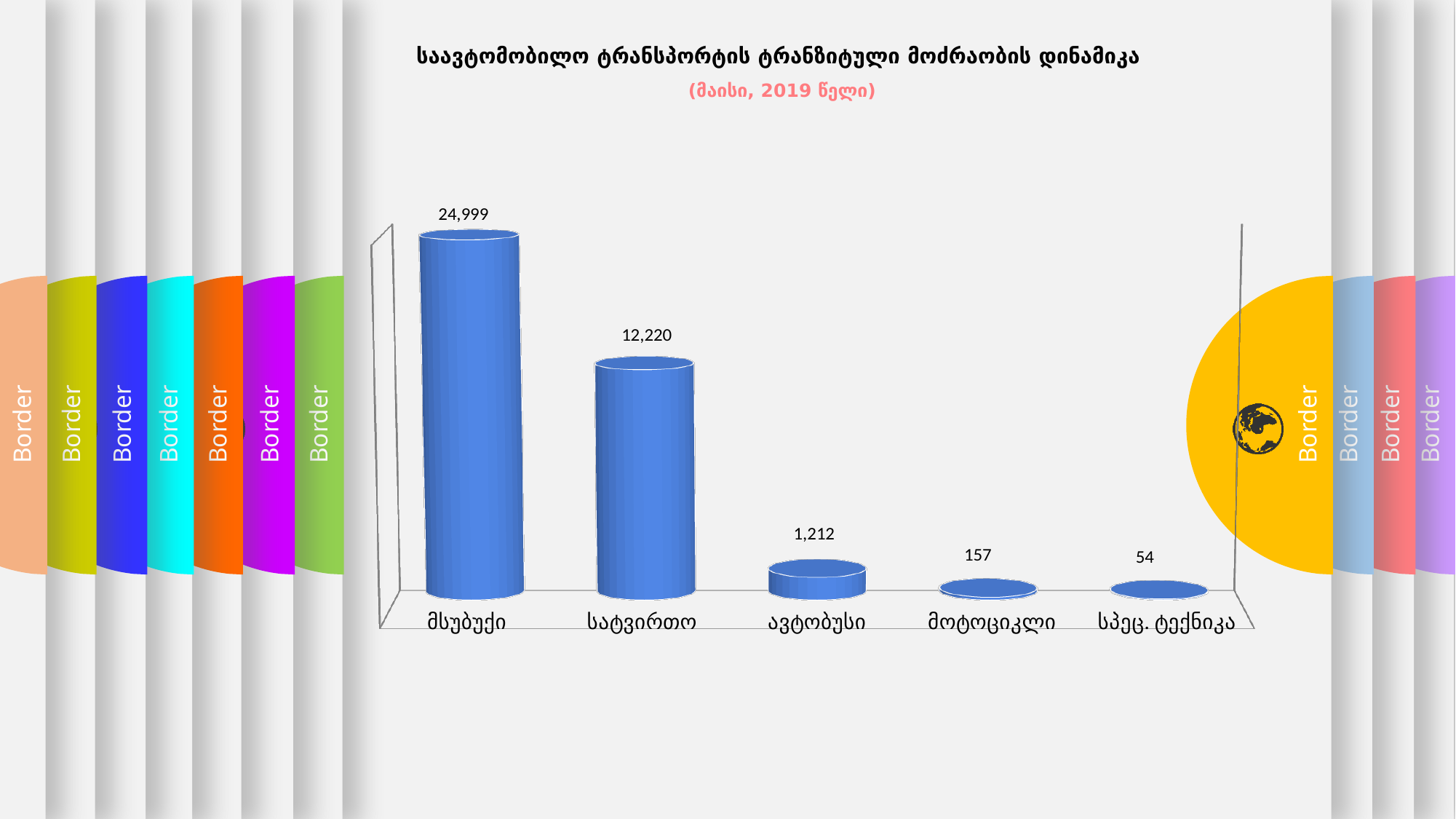
What is the value for სპეც. ტექნიკა? 54 Which is larger, the value for ავტობუსი or the value for მოტოციკლი? ავტობუსი Which month and year does the chart subtitle refer to? მაისი, 2019 წელი What is the value for სატვირთო? 12,220 How many categories are shown in the chart? 5 What is the value for მსუბუქი? 24,999 What is the difference between the values for მსუბუქი and სატვირთო? 12,779 What is the value for მოტოციკლი? 157 What kind of chart is shown on the slide? Bar chart What is the value for ავტობუსი? 1,212 Which category has the highest value? მსუბუქი Which category has the lowest value? სპეც. ტექნიკა